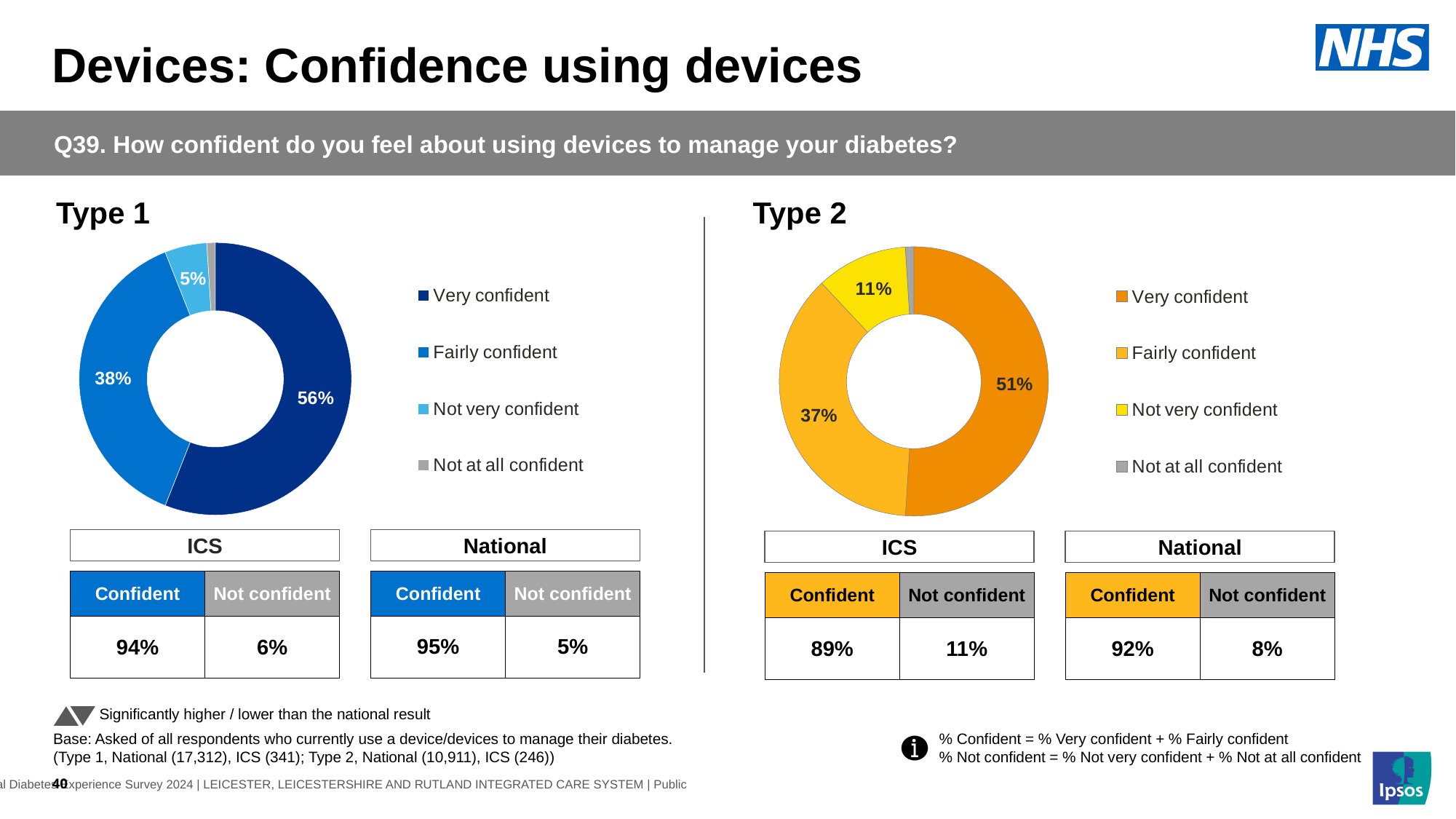
In the Type 1 chart, what percentage of respondents are not very confident? 5% What kind of chart is used for Type 1? Donut (pie) chart How many categories does the legend of the Type 2 chart list? 4 In the Type 2 chart, what percentage of respondents are very confident? 51% In the Type 1 chart, what is the difference between the very confident and fairly confident shares? 18% In the Type 1 chart, which category has the smallest share? Not at all confident In the Type 2 chart, what percentage of respondents are not very confident? 11% In the Type 2 chart, what colour represents the 'Not very confident' category? Yellow In the Type 2 chart, which category has the largest share? Very confident In the Type 1 chart, what percentage of respondents are very confident? 56% Is the very confident share larger in the Type 1 chart or the Type 2 chart? Type 1 In the Type 1 chart, what percentage of respondents are fairly confident? 38%